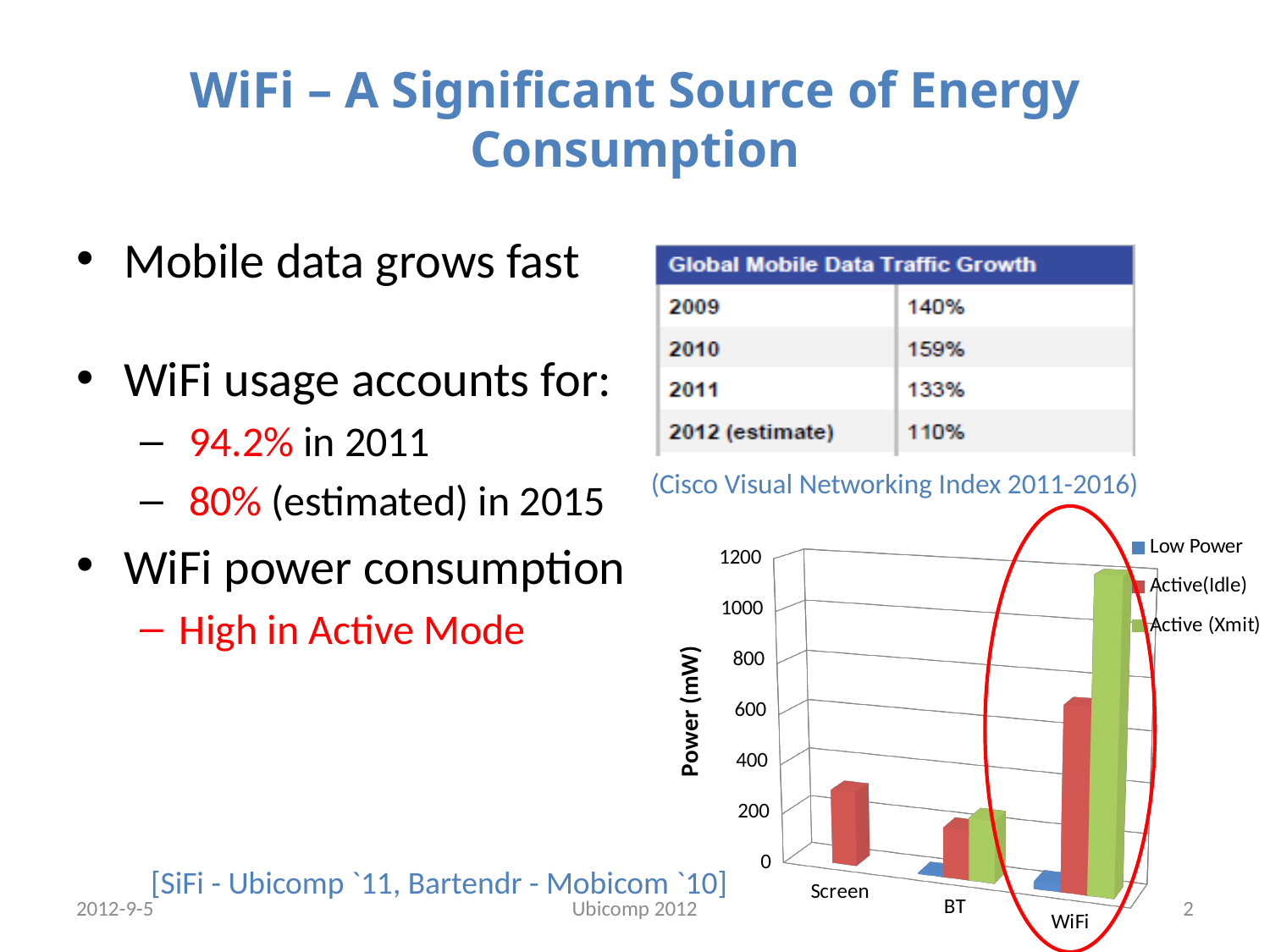
What is the title of the vertical axis of the bar chart? Power (mW) Which category has the highest Active (Xmit) value in the bar chart? WiFi How many categories are shown on the x axis of the bar chart? 3 What kind of chart is shown on the slide? bar chart Which is larger in the bar chart: the Active (Xmit) value for WiFi or the Active(Idle) value for Screen? Active (Xmit) for WiFi Is the Active (Xmit) value for WiFi greater or less than 1000? greater For WiFi, which series has the highest value in the bar chart? Active (Xmit) For WiFi, which series has the lowest value in the bar chart? Low Power How many series does the legend of the bar chart list? 3 Which category is circled in red on the bar chart? WiFi Which category has the highest Active(Idle) value in the bar chart? WiFi Is the Active(Idle) value for Screen greater or less than 400? less